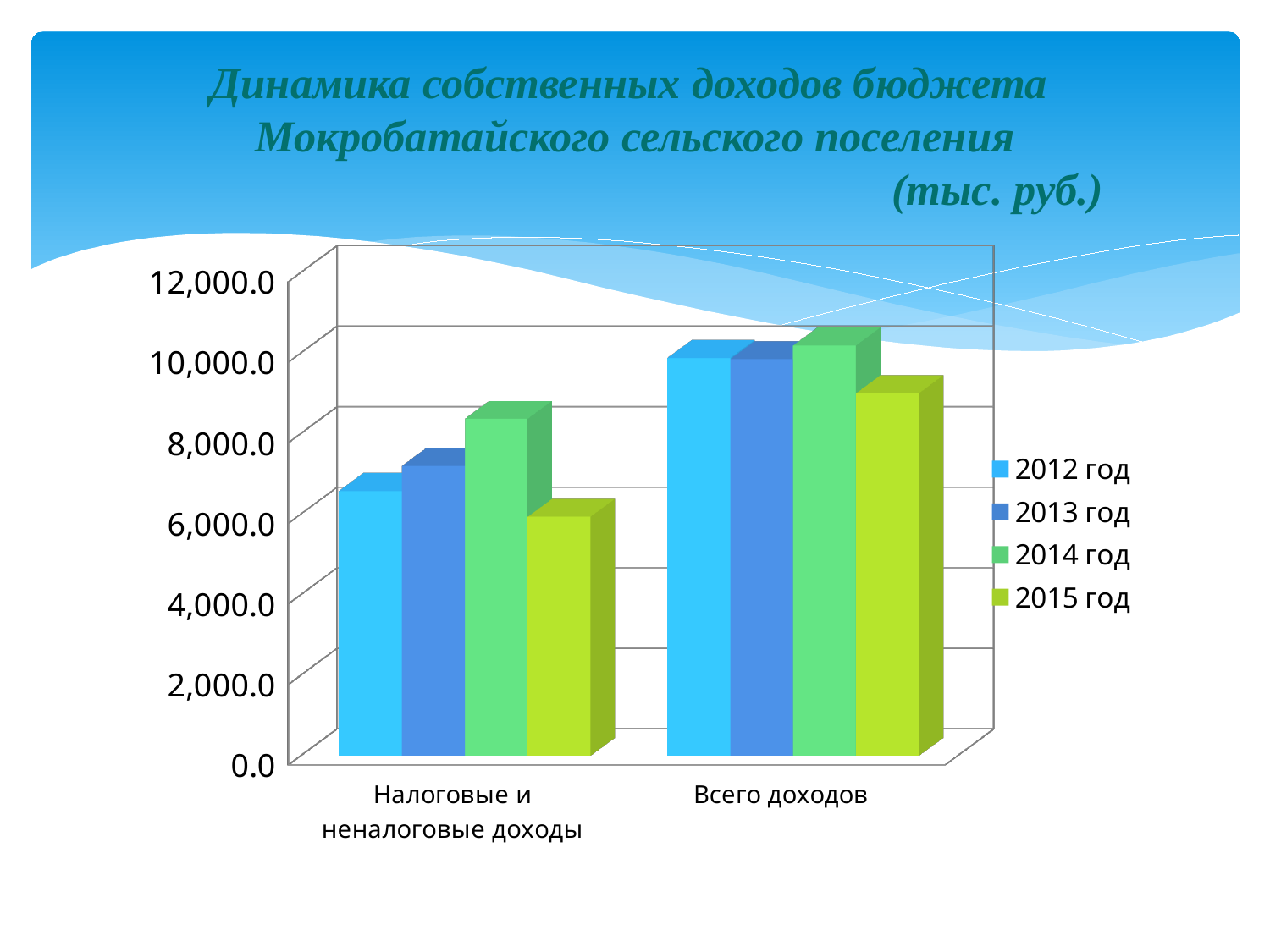
Which year has the lowest value for Налоговые и неналоговые доходы? 2015 год What kind of chart is shown on the slide? bar chart Is the value for 2015 год in Всего доходов greater or less than 10,000.0? less Which year has the lowest value for Всего доходов? 2015 год For Налоговые и неналоговые доходы, which is larger: the value for 2012 год or 2013 год? 2013 год What unit is given in the chart title? тыс. руб. Is the value for 2015 год in Налоговые и неналоговые доходы greater or less than 8,000.0? less Is the value for 2012 год in Всего доходов greater or less than 8,000.0? greater How many categories are shown on the x axis? 2 How many series does the legend list? 4 Which year has the highest value for Налоговые и неналоговые доходы? 2014 год